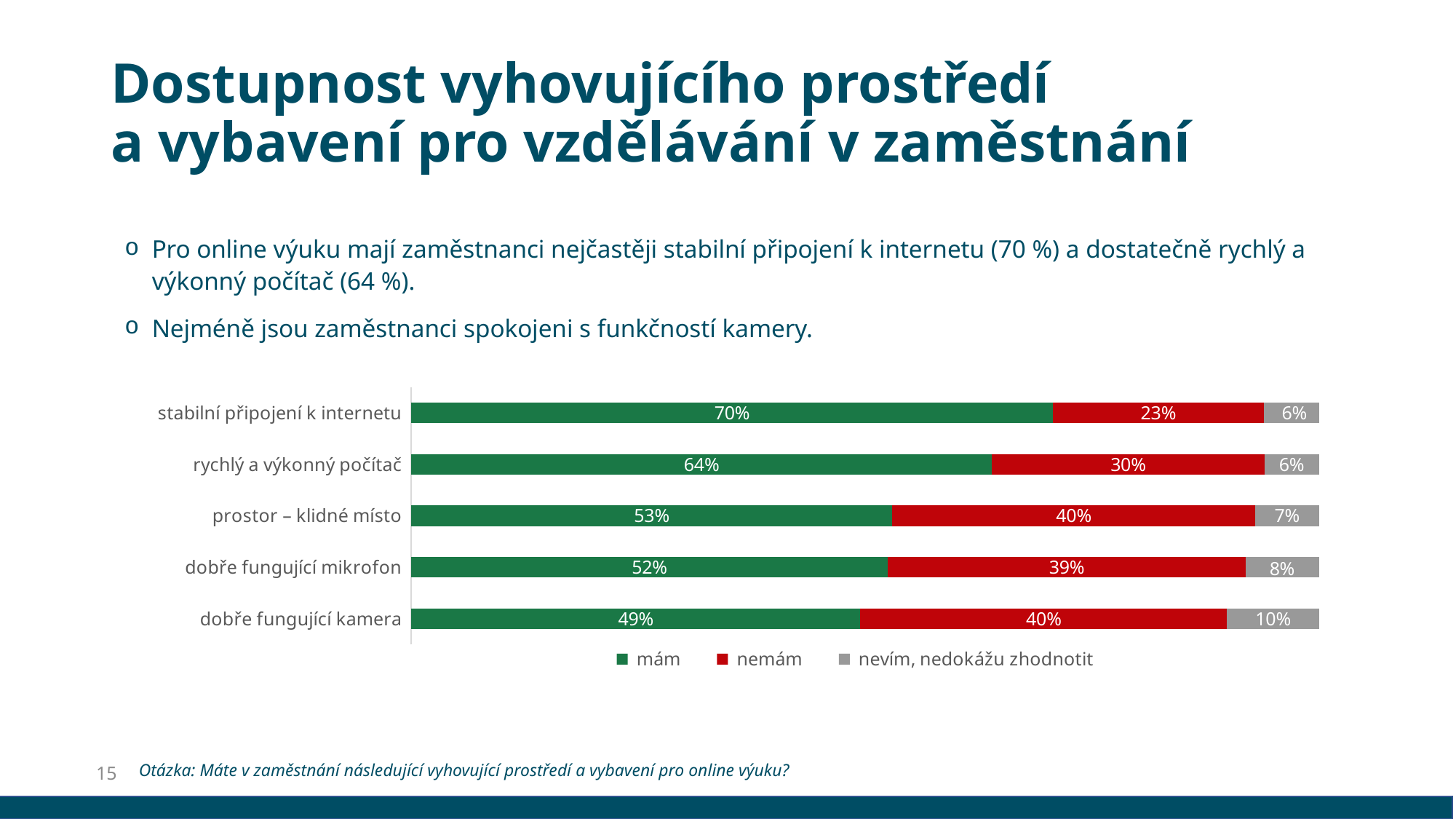
Which colour represents the 'nemám' series in the chart? red What kind of chart is shown on the slide? stacked bar chart What is the 'nevím, nedokážu zhodnotit' value for 'dobře fungující kamera'? 10% Which category has the highest 'mám' value? stabilní připojení k internetu What is the difference between the 'mám' values for 'stabilní připojení k internetu' and 'rychlý a výkonný počítač'? 6% What is the total of the stacked bar for 'dobře fungující mikrofon'? 99% How many categories are shown in the chart? 5 How many series does the legend list? 3 Which is larger: the 'nemám' value for 'prostor – klidné místo' or for 'dobře fungující mikrofon'? prostor – klidné místo What is the 'nemám' value for 'rychlý a výkonný počítač'? 30% What is the 'mám' value for 'stabilní připojení k internetu'? 70% Which category has the lowest 'mám' value? dobře fungující kamera